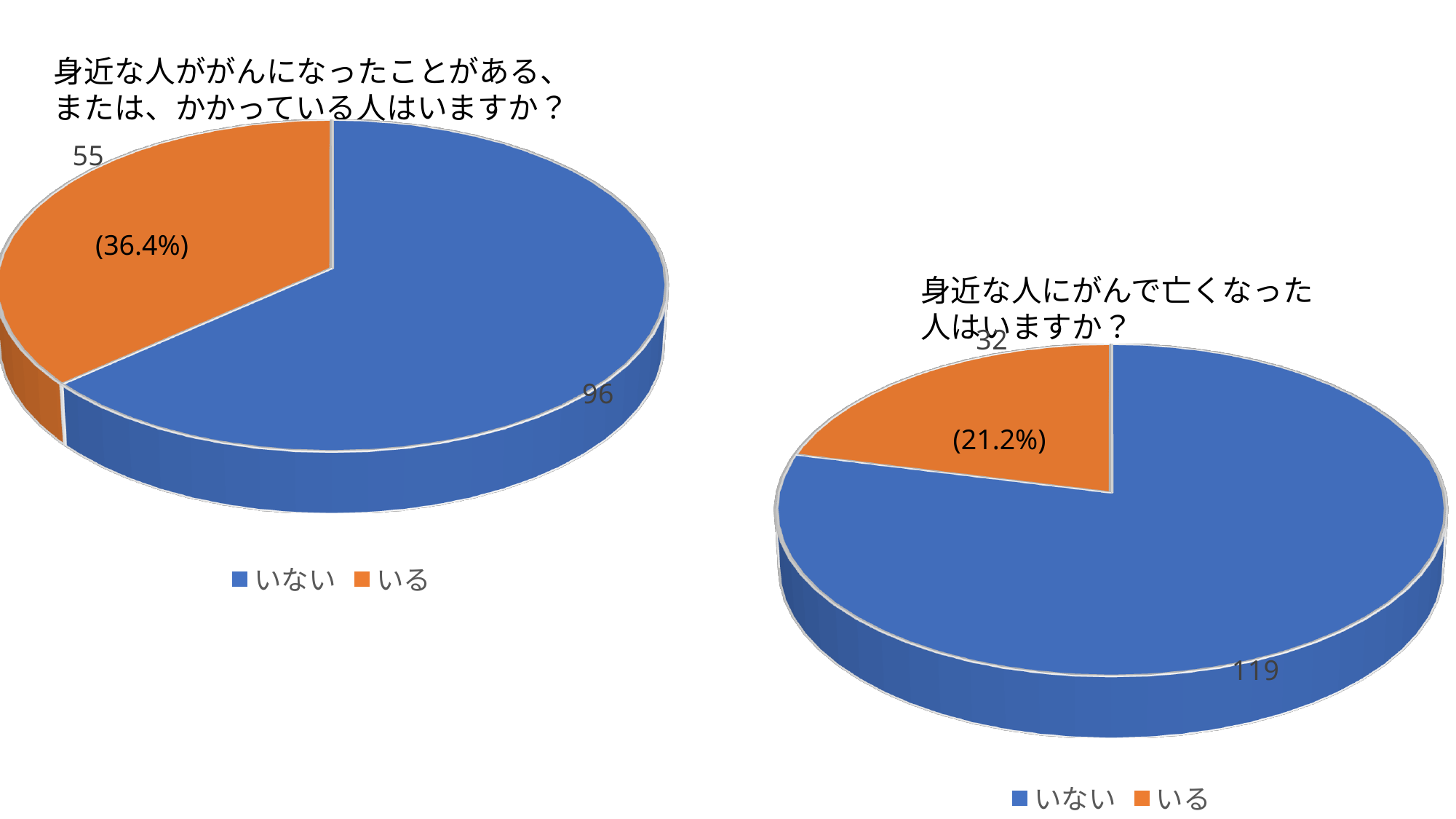
In the right chart (身近な人にがんで亡くなった人はいますか？), what is the value for いない? 119 In the left chart (身近な人ががんになったことがある、または、かかっている人はいますか？), what share of the pie does いる represent? 36.4% In the left chart (身近な人ががんになったことがある、または、かかっている人はいますか？), what is the difference between いない and いる? 41 In the right chart (身近な人にがんで亡くなった人はいますか？), which category is smallest? いる In the left chart (身近な人ががんになったことがある、または、かかっている人はいますか？), what is the value for いない? 96 How many categories does the legend of the right chart (身近な人にがんで亡くなった人はいますか？) list? 2 In the right chart (身近な人にがんで亡くなった人はいますか？), what is the total of いない and いる? 151 In the left chart (身近な人ががんになったことがある、または、かかっている人はいますか？), which category is largest? いない In the right chart (身近な人にがんで亡くなった人はいますか？), what share of the pie does いる represent? 21.2% In the right chart (身近な人にがんで亡くなった人はいますか？), what is the value for いる? 32 In the left chart (身近な人ががんになったことがある、または、かかっている人はいますか？), what is the value for いる? 55 What kind of chart is the left chart titled 「身近な人ががんになったことがある、または、かかっている人はいますか？」? pie chart